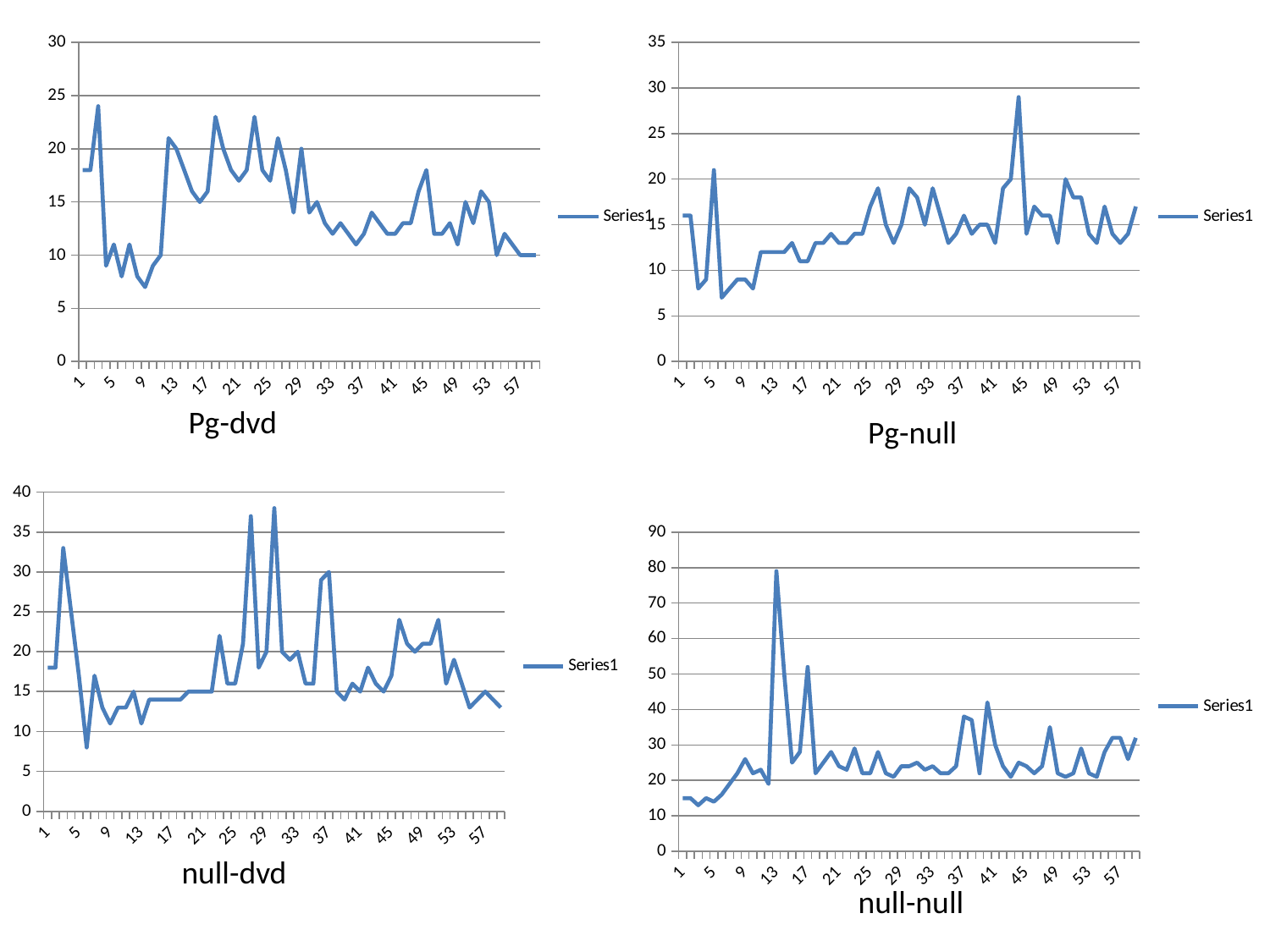
In the null-dvd chart, is the value at x = 6 greater or less than 10? less In the Pg-dvd chart, is the value at x = 3 greater or less than 20? greater In the null-null chart, is the value at x = 1 greater or less than 20? less How many series does the legend of the null-null chart list? 1 What kind of chart is the Pg-dvd chart? line chart What is the name of the series shown in the legend of the Pg-null chart? Series1 Which of the four charts has the largest maximum value on its y axis? null-null